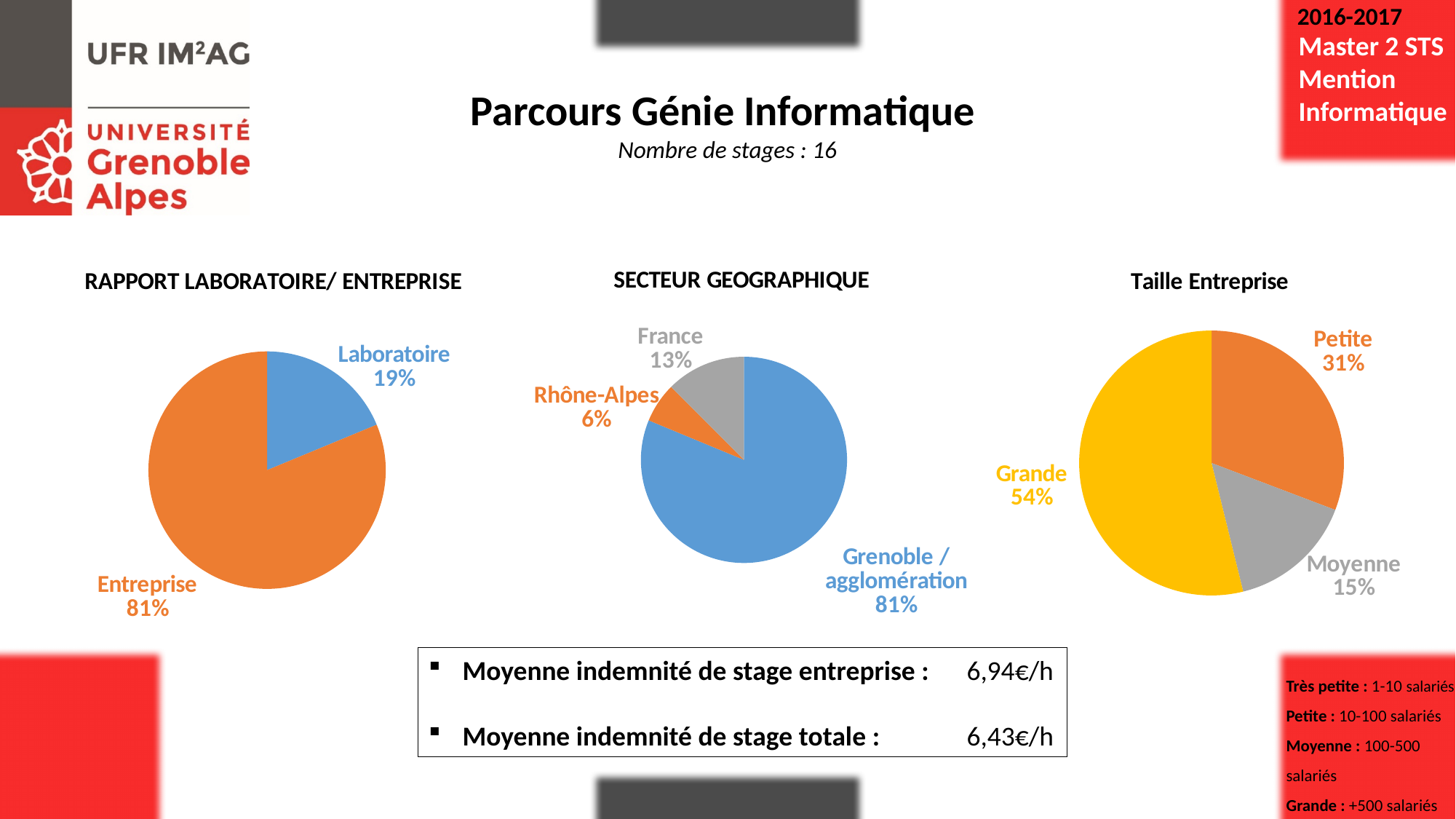
In the 'RAPPORT LABORATOIRE/ ENTREPRISE' chart, what share does Laboratoire have? 19% In the 'Taille Entreprise' chart, what colour is the Grande slice? Yellow In the 'RAPPORT LABORATOIRE/ ENTREPRISE' chart, what share does Entreprise have? 81% In the 'SECTEUR GEOGRAPHIQUE' chart, which category has the largest share? Grenoble / agglomération In the 'Taille Entreprise' chart, what is the difference between the Grande and Petite shares? 23% What type of chart is the 'Taille Entreprise' chart? Pie chart How many categories does the 'SECTEUR GEOGRAPHIQUE' pie chart have? 3 In the 'SECTEUR GEOGRAPHIQUE' chart, what share does France have? 13% In the 'Taille Entreprise' chart, what share does Moyenne have? 15% In the 'RAPPORT LABORATOIRE/ ENTREPRISE' chart, what is the difference between the Entreprise and Laboratoire shares? 62% In the 'Taille Entreprise' chart, which is larger, Petite or Moyenne? Petite In the 'SECTEUR GEOGRAPHIQUE' chart, which category has the smallest share? Rhône-Alpes